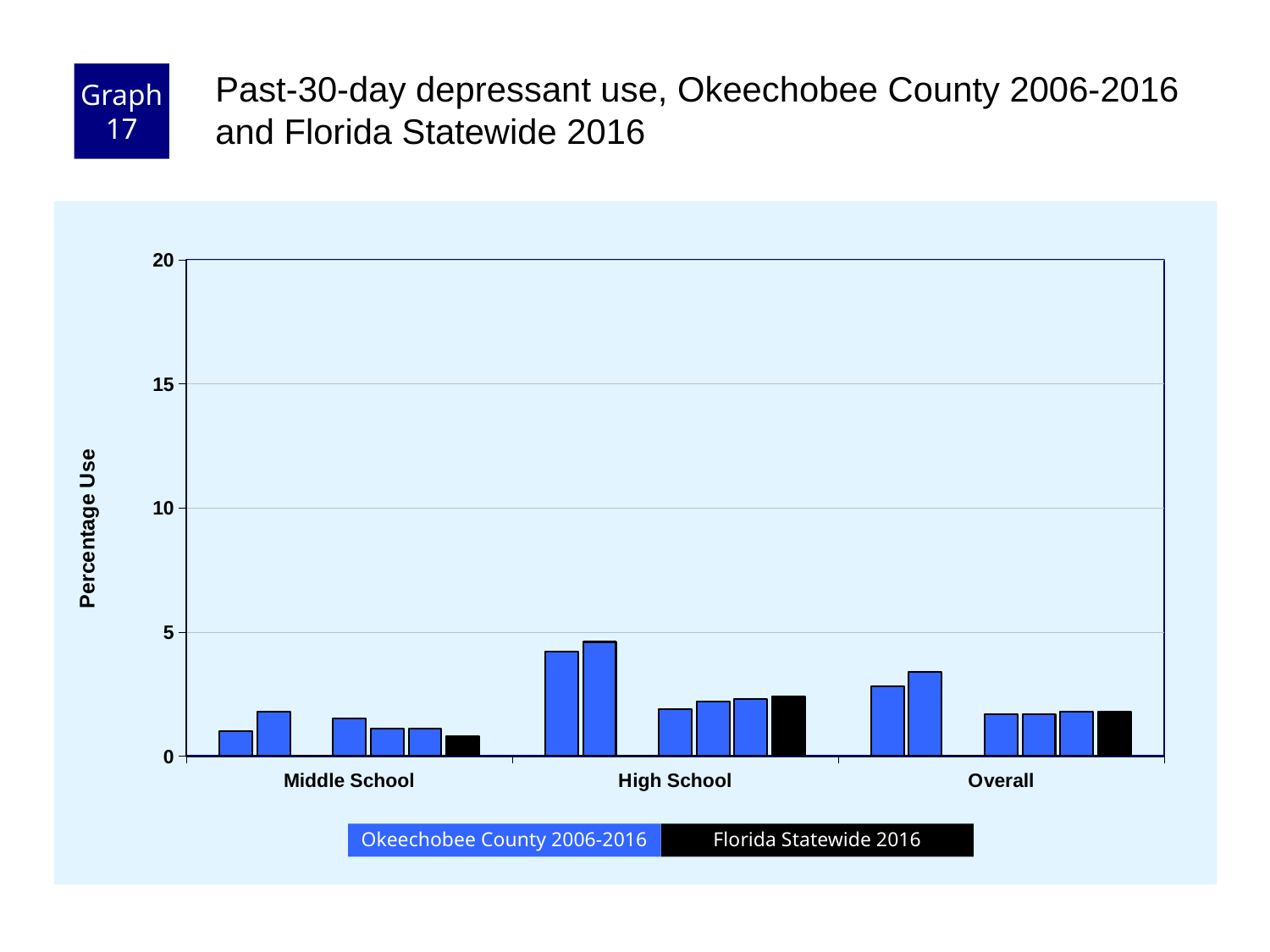
Which category contains the tallest bar in the chart? High School Is the Florida Statewide 2016 value for High School greater or less than 5? less Which series does the black bar represent? Florida Statewide 2016 Are all the bars in the chart below 10 on the y axis? yes What kind of chart is shown on the slide? bar chart How many school-level categories are shown on the x axis? 3 Is the Florida Statewide 2016 bar larger for Overall or for Middle School? Overall Is the Florida Statewide 2016 bar larger for High School or for Middle School? High School Which category contains the shortest bar in the chart? Middle School What is the label on the y axis? Percentage Use How many series does the legend list? 2 Is the Florida Statewide 2016 value for Middle School greater or less than 5? less